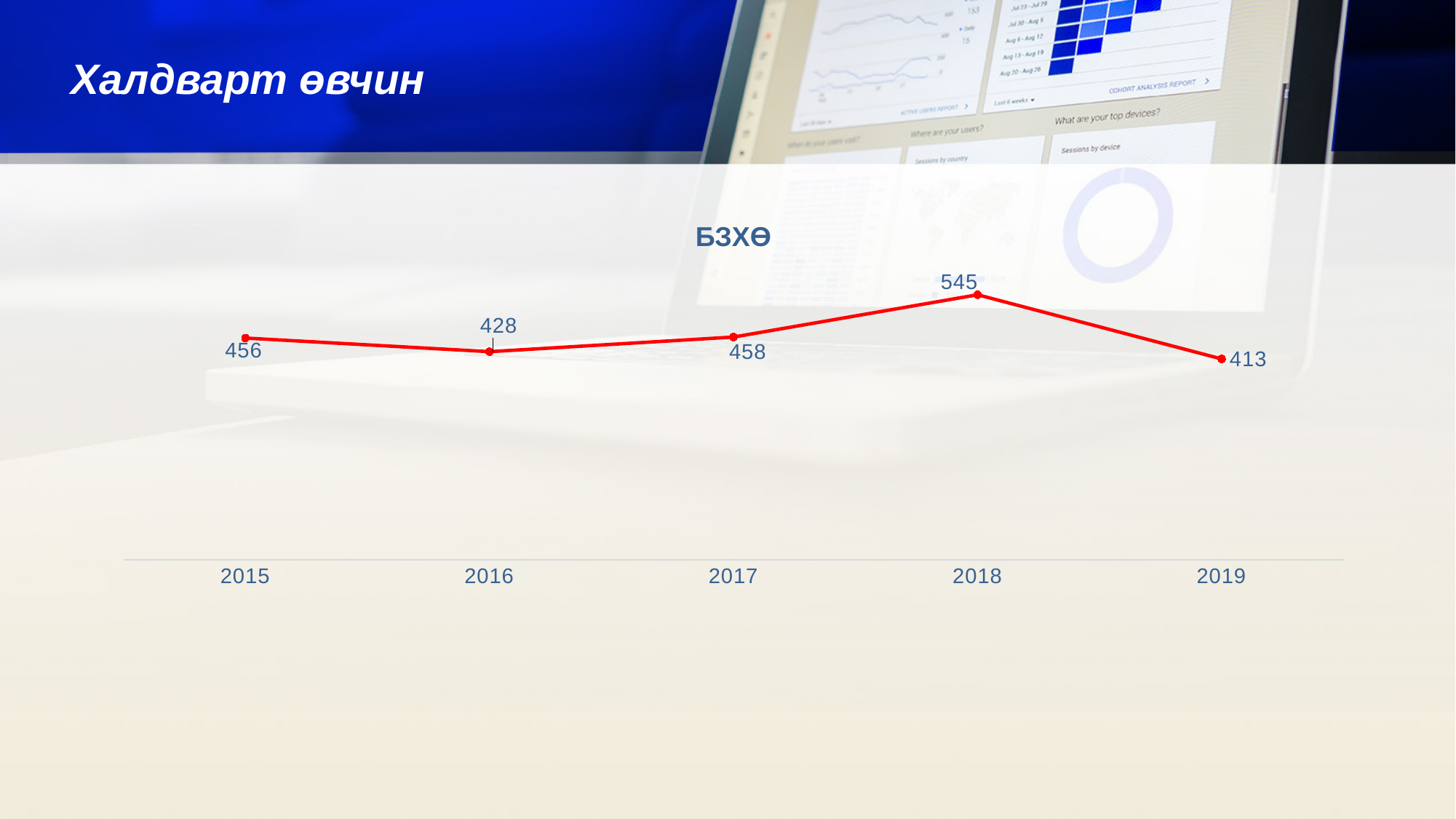
Which year has the highest value? 2018 What kind of chart is shown on the slide? line chart What is the title of the chart? БЗХӨ What is the difference between the values for 2018 and 2019? 132 What is the value for 2019? 413 What is the value for 2016? 428 Which year has the lowest value? 2019 How many years are plotted on the chart? 5 What is the value for 2017? 458 Which is larger, the value for 2015 or the value for 2016? 2015 What is the value for 2018? 545 What is the value for 2015? 456